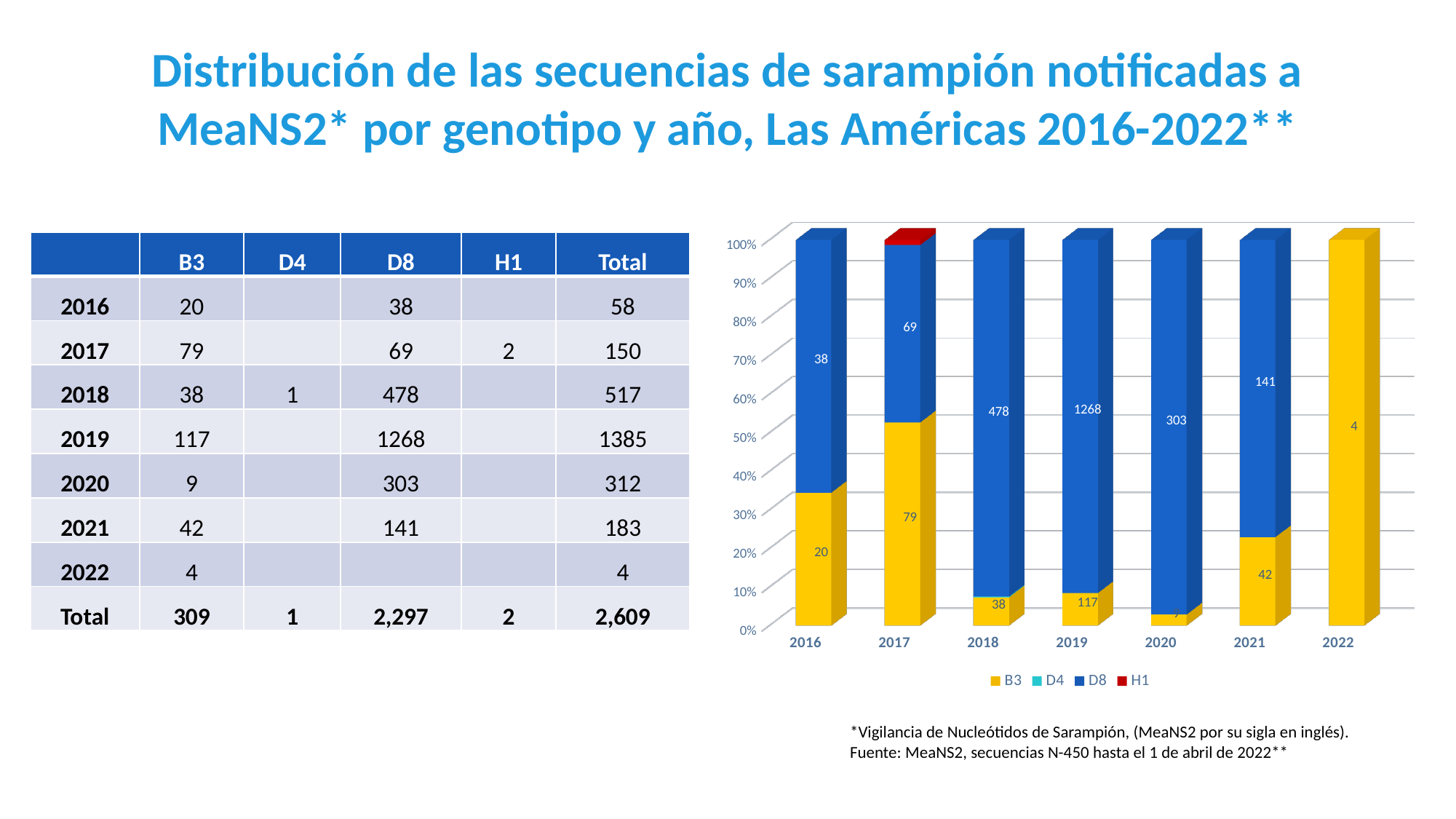
In the chart, is the share of the 2017 bar taken by B3 greater or less than 50%? greater What is the B3 value labelled for 2017 in the chart? 79 Which year has the lowest labelled B3 value in the chart? 2022 What kind of chart is shown on the slide? bar chart In the chart, is the labelled B3 value for 2018 or the labelled B3 value for 2021 larger? 2021 What is the difference between the D8 values labelled for 2019 and 2018 in the chart? 790 What is the D8 value labelled for 2021 in the chart? 141 Which year has the highest labelled D8 value in the chart? 2019 What is the B3 value labelled for 2022 in the chart? 4 How many years are shown on the x axis of the chart? 7 How many series does the chart legend list? 4 What is the D8 value labelled for 2019 in the chart? 1268